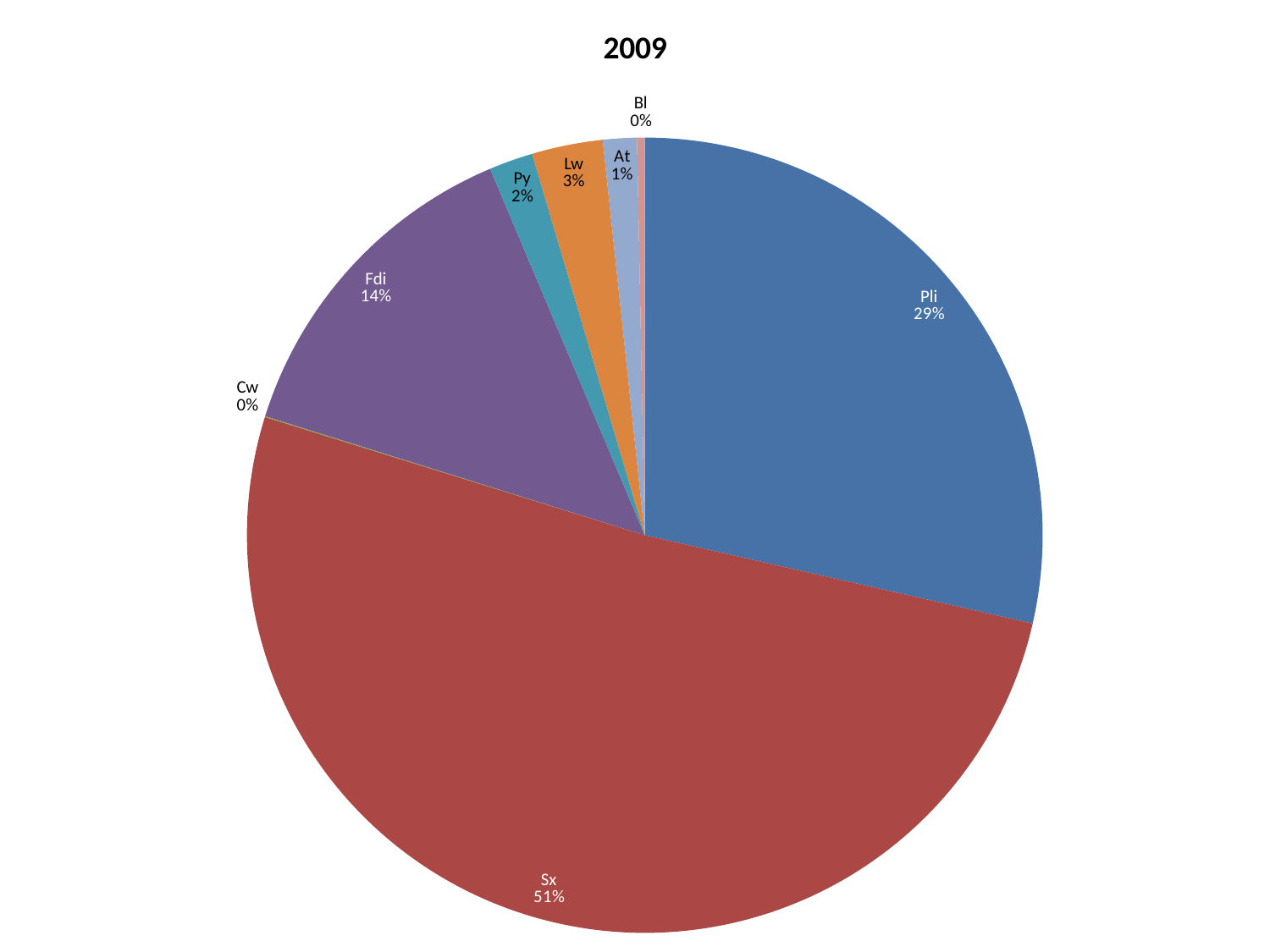
What is the value shown for Py? 2% What share of the pie does Pli have? 29% What is the difference between the shares of Sx and Pli? 22% Which category has the largest slice of the pie? Sx What share of the pie does Fdi have? 14% What kind of chart is shown on the slide? pie chart What share of the pie does Sx have? 51% What is the value shown for Lw? 3% What is the value shown for At? 1% What is the title of the chart? 2009 Which is larger, Pli or Fdi? Pli How many categories are labelled on the pie chart? 8